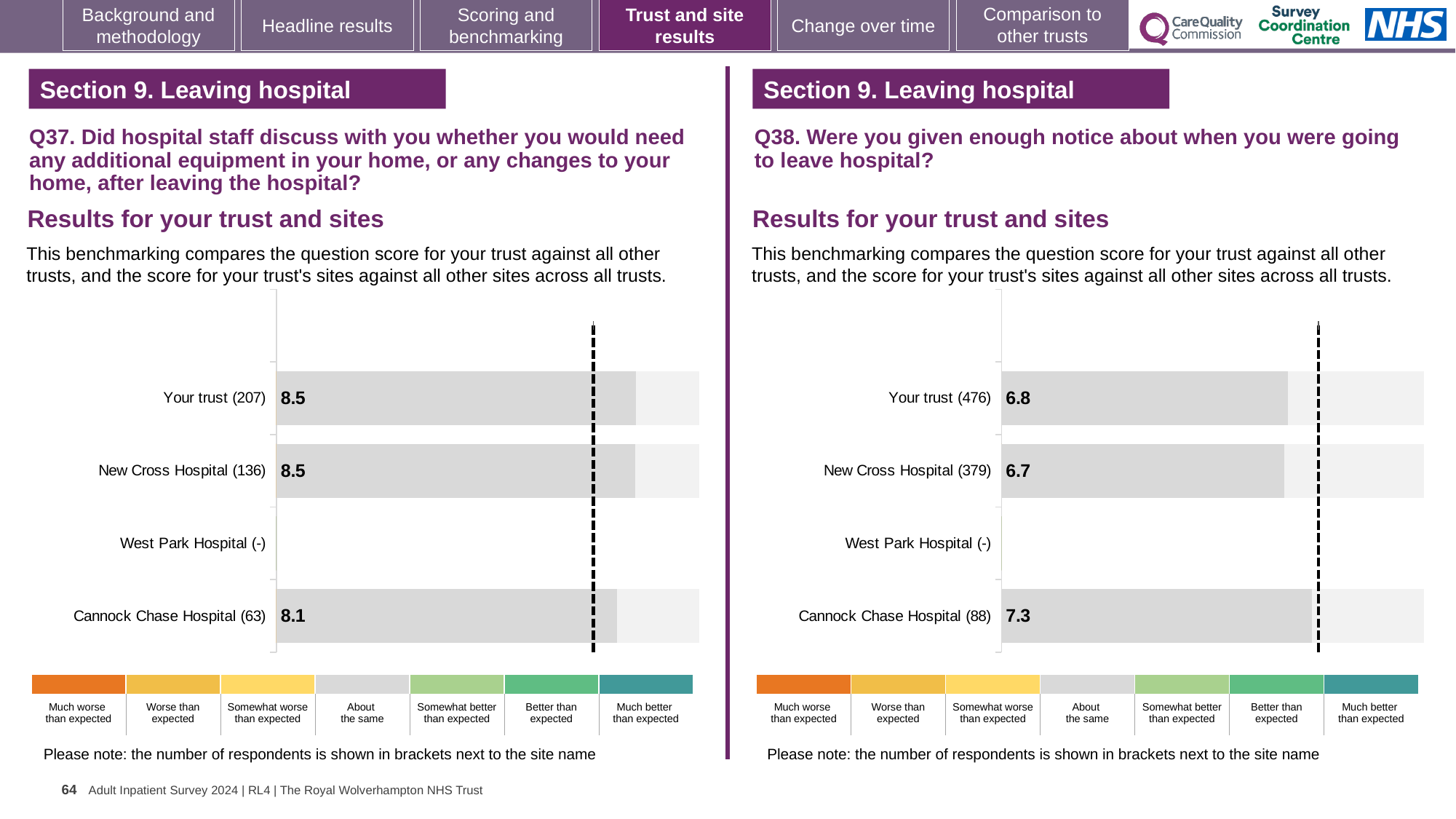
On the Q37 chart (left), what is the score for Your trust? 8.5 On the Q38 chart (right), what is the difference between the score for Cannock Chase Hospital and the score for Your trust? 0.5 On the Q38 chart (right), what is the score for New Cross Hospital? 6.7 On the Q38 chart (right), which site or trust has the highest score? Cannock Chase Hospital On the Q38 chart (right), how many respondents are shown in brackets for Your trust? 476 On the Q37 chart (left), what is the difference between the score for Your trust and the score for Cannock Chase Hospital? 0.4 On the Q38 chart (right), which is larger: the score for Your trust or the score for Cannock Chase Hospital? Cannock Chase Hospital How many categories (trust and sites) are listed on the Q37 chart (left)? 4 On the Q37 chart (left), what is the score for Cannock Chase Hospital? 8.1 What kind of chart is used on the Q38 chart (right)? Bar chart On the Q38 chart (right), what is the score for Cannock Chase Hospital? 7.3 On the Q37 chart (left), which site has the lowest score among those with a value shown? Cannock Chase Hospital